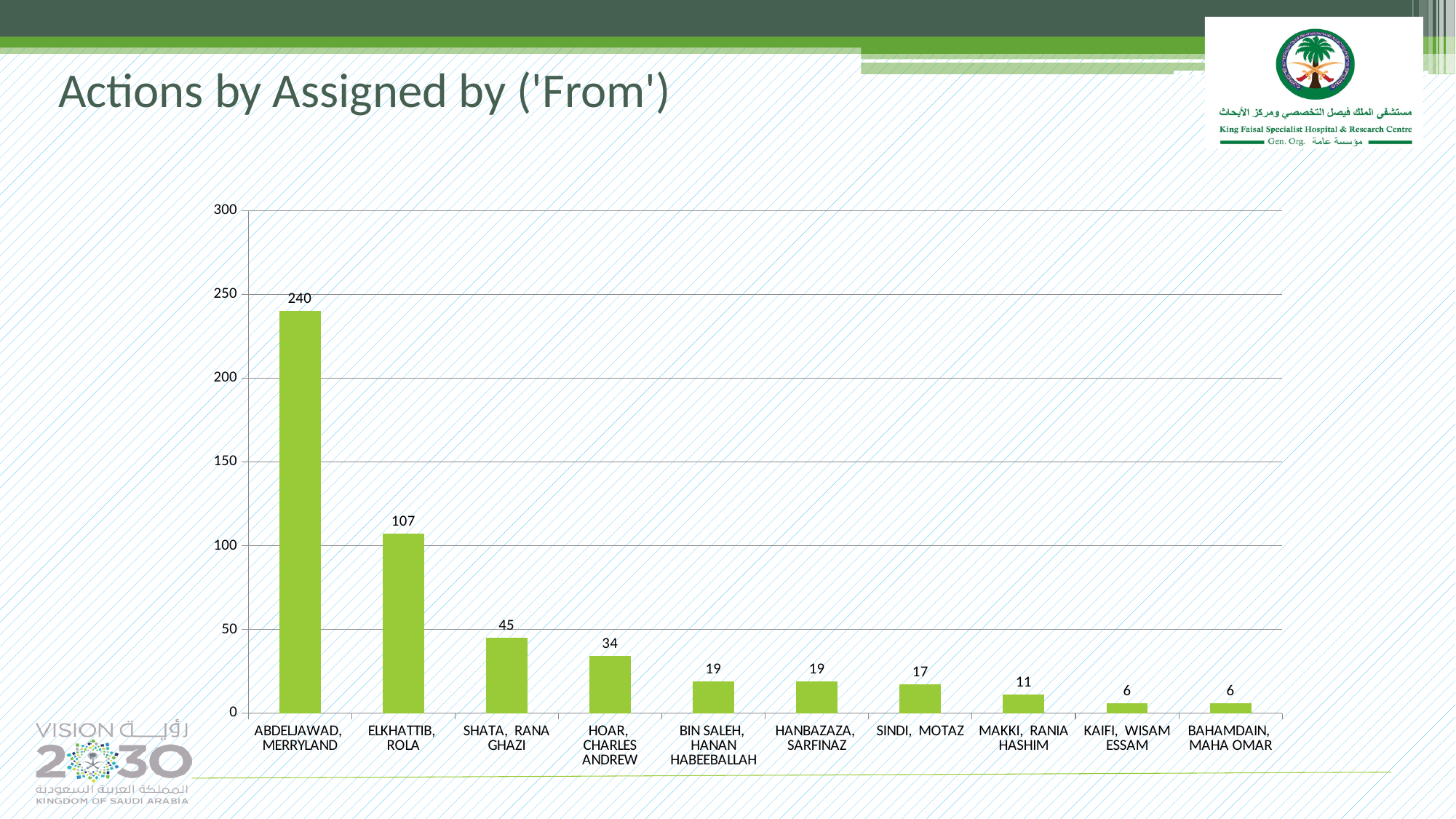
What is the value for HOAR, CHARLES ANDREW? 34 What is the value for ELKHATTIB, ROLA? 107 Which category has the highest value? ABDELJAWAD, MERRYLAND Which is larger, the value for SINDI, MOTAZ or the value for KAIFI, WISAM ESSAM? SINDI, MOTAZ What is the title of the chart? Actions by Assigned by ('From') What is the difference between the values for SHATA, RANA GHAZI and HOAR, CHARLES ANDREW? 11 What is the difference between the values for ABDELJAWAD, MERRYLAND and ELKHATTIB, ROLA? 133 What is the value for ABDELJAWAD, MERRYLAND? 240 Is the value for ELKHATTIB, ROLA greater or less than 100? greater What kind of chart is shown on the slide? Bar chart What is the value for MAKKI, RANIA HASHIM? 11 How many categories are shown on the x axis? 10